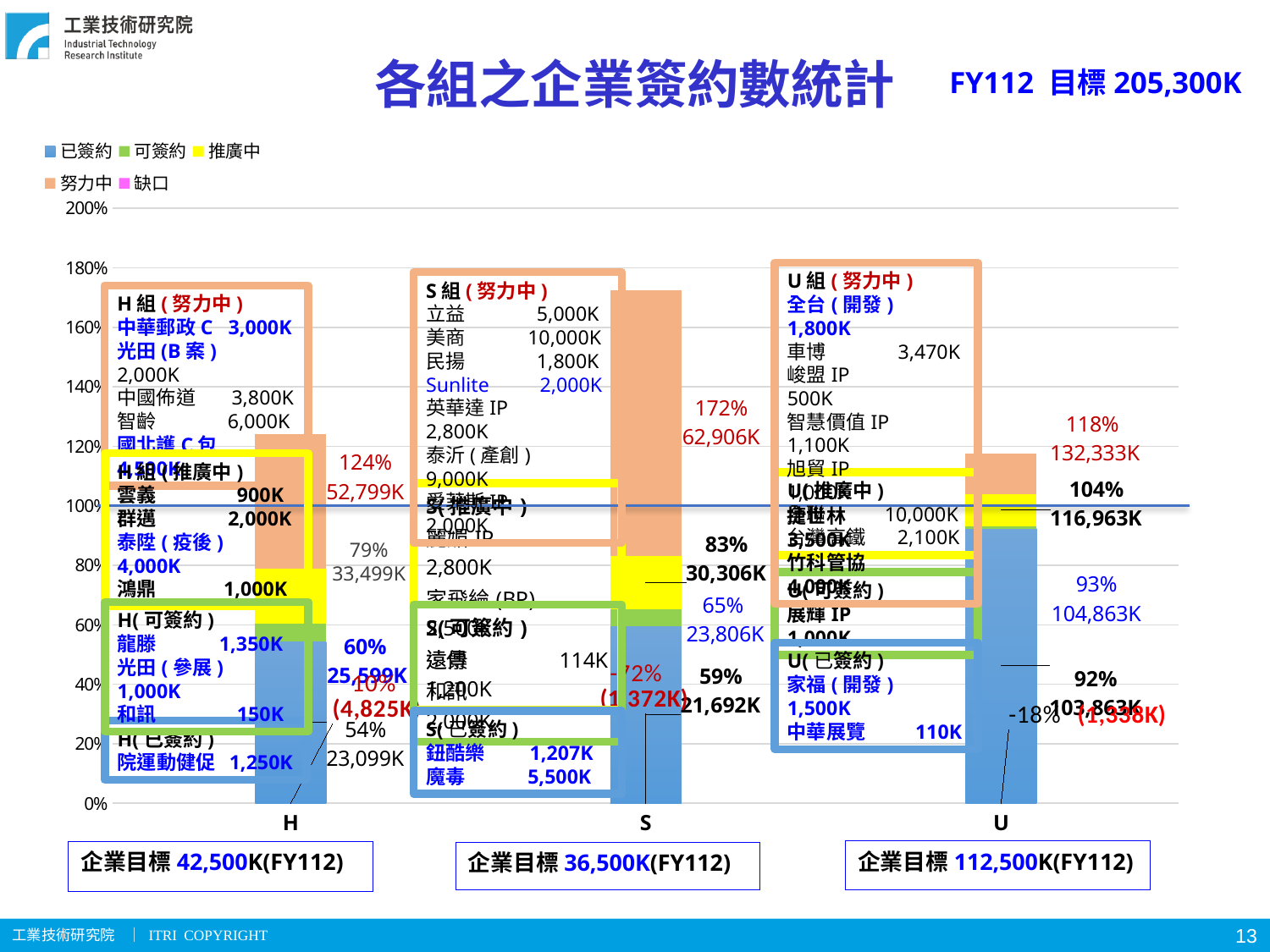
How many series does the legend list? 5 What is the difference between the topmost cumulative value of the S group (62,906K) and that of the H group (52,799K)? 10,107K What is the topmost cumulative value in K shown for the U group? 132,333K Which is larger, the 已簽約 value for H (23,099K) or the 已簽約 value for S (21,692K)? H What kind of chart is shown on the slide? bar chart How many groups (categories) are plotted along the x axis? 3 Which group has the highest topmost cumulative percentage? S What is the 企業目標 (enterprise target) shown for the U group? 112,500K What is the 已簽約 (signed) value in K shown for the U group? 103,863K What is the 已簽約 (signed) percentage label shown for the H group? 54% Is the top of the S group's stacked bar greater or less than 160%? greater What is the topmost cumulative percentage label shown for the S group? 172%